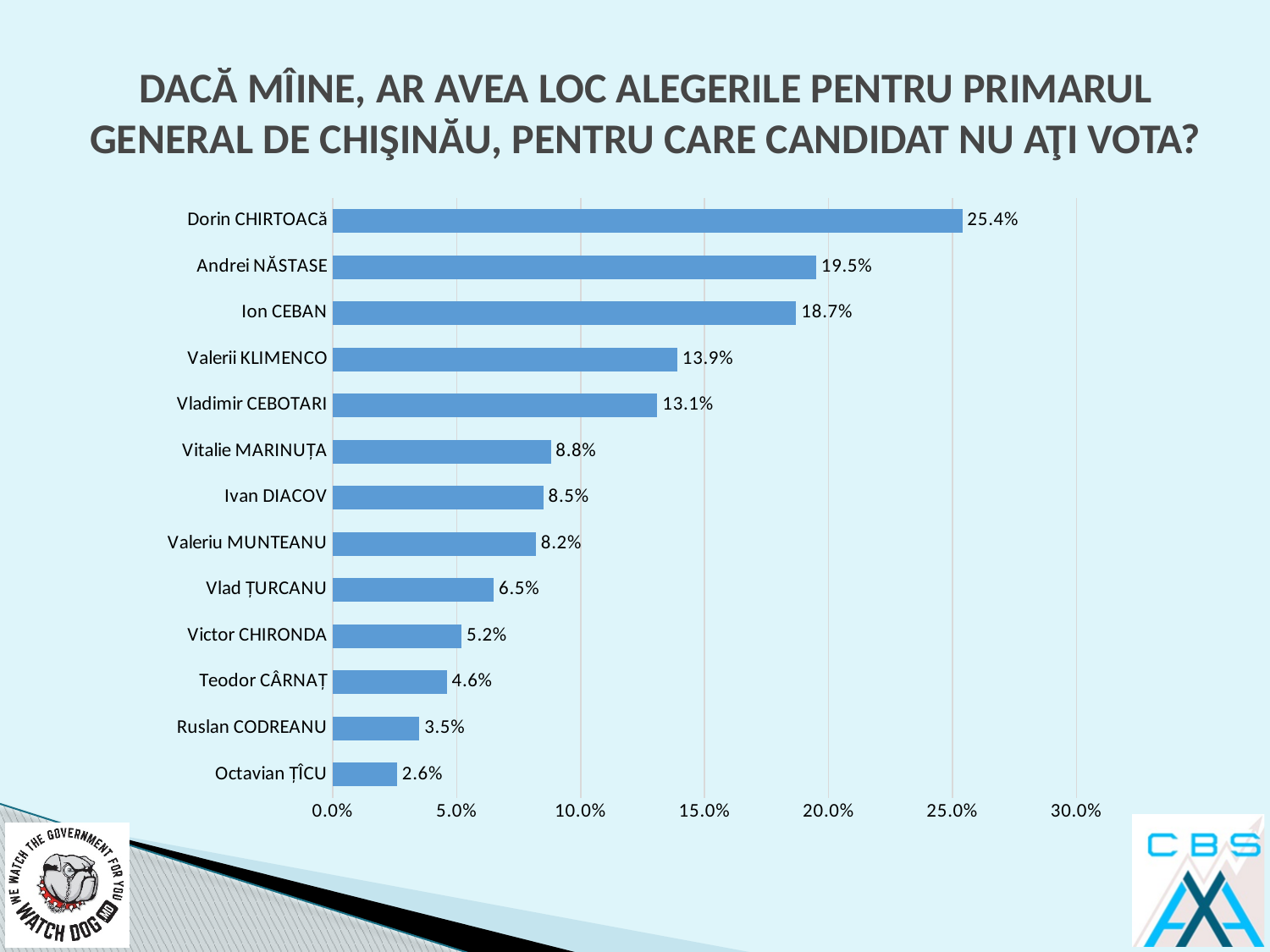
What kind of chart is shown on the slide? bar chart Which is larger, the value for Valerii KLIMENCO or the value for Vitalie MARINUȚA? Valerii KLIMENCO What is the value for Vladimir CEBOTARI? 13.1% What is the difference between the values for Dorin CHIRTOACă and Octavian ȚÎCU? 22.8% What is the value for Ruslan CODREANU? 3.5% What is the difference between the values for Andrei NĂSTASE and Ion CEBAN? 0.8% What is the highest value shown on the x axis? 30.0% Which candidate has the highest value? Dorin CHIRTOACă Is the value for Vlad ȚURCANU greater or less than 5.0%? greater Which candidate has the lowest value? Octavian ȚÎCU How many candidates are shown in the chart? 13 What is the value for Dorin CHIRTOACă? 25.4%